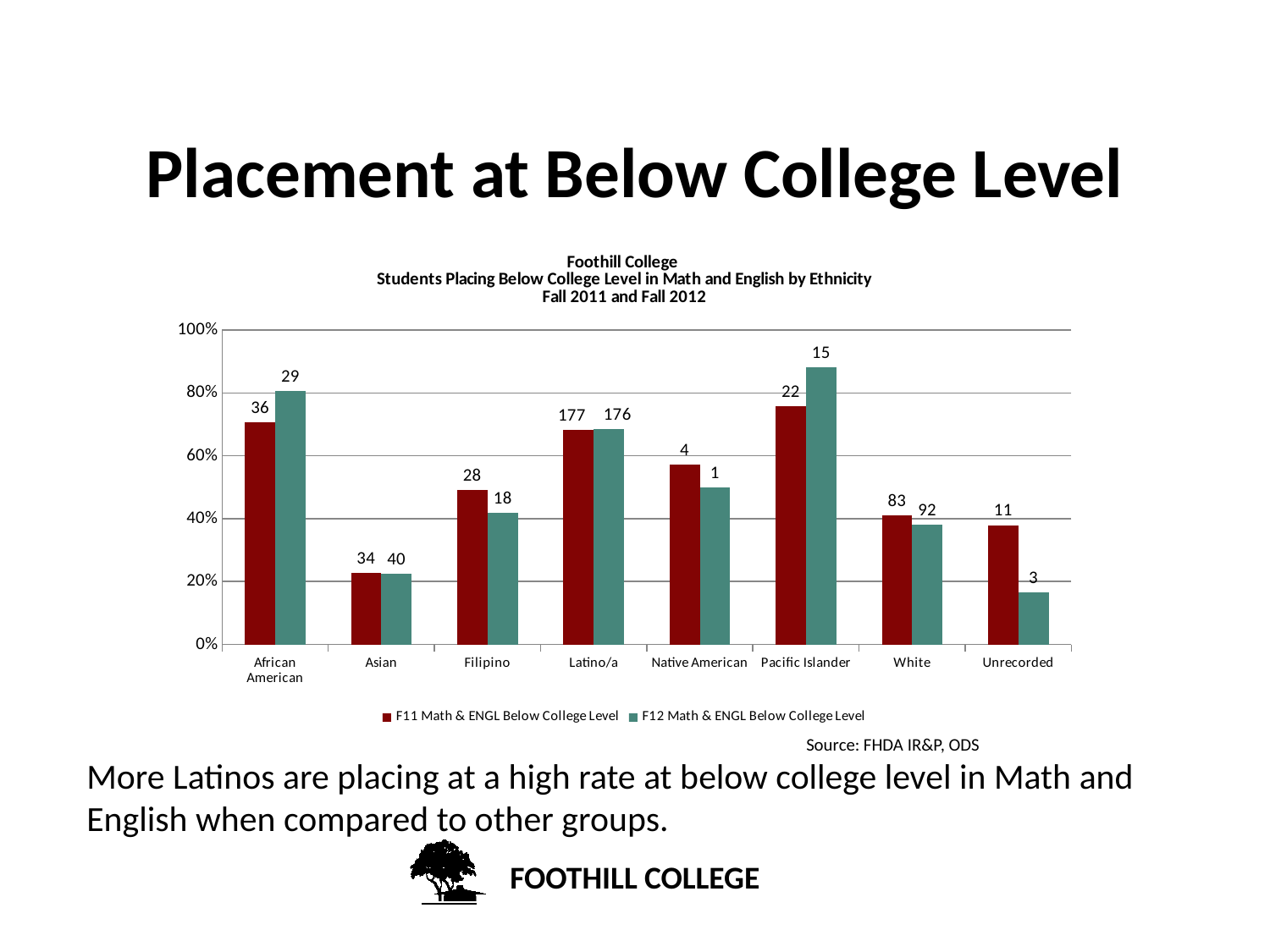
What source is cited below the chart? FHDA IR&P, ODS What type of chart is shown on the slide? bar chart How many ethnicity categories are shown on the x axis? 8 Is the F12 Math & ENGL Below College Level bar for African American greater or less than 60%? greater What data label is shown on the F11 Math & ENGL Below College Level bar for Latino/a? 177 What data label is shown on the F12 Math & ENGL Below College Level bar for White? 92 Which category has the shortest F11 Math & ENGL Below College Level bar? Asian How many series does the legend list? 2 For Pacific Islander, which bar is taller: F11 or F12 Math & ENGL Below College Level? F12 Math & ENGL Below College Level What is the difference between the data labels on the F12 and F11 bars for White? 9 Which category has the tallest F12 Math & ENGL Below College Level bar? Pacific Islander Is the F12 Math & ENGL Below College Level bar for Unrecorded greater or less than 20%? less